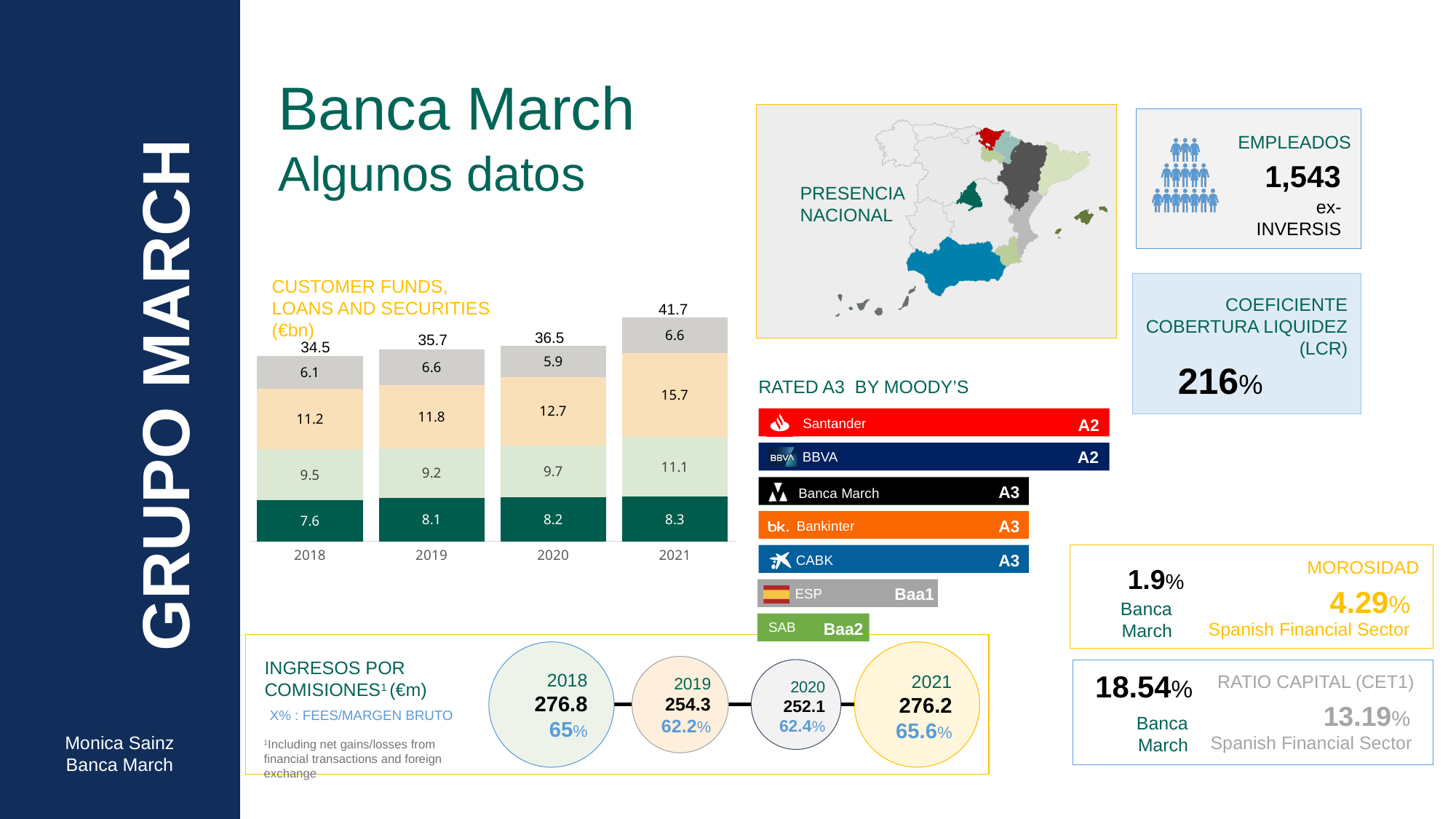
In the 'Customer funds, loans and securities (€bn)' chart, what is the value of the peach (second from top) segment for 2020? 12.7 How many years are shown on the x axis of the 'Customer funds, loans and securities (€bn)' chart? 4 What kind of chart is the 'Customer funds, loans and securities (€bn)' chart? Stacked bar chart In the 'Ingresos por comisiones (€m)' graphic, what is the value for 2019? 254.3 In the 'Customer funds, loans and securities (€bn)' chart, do the totals rise or fall from 2018 to 2021? Rise In the 'Customer funds, loans and securities (€bn)' chart, what is the value of the bottom dark green segment for 2018? 7.6 In the 'Customer funds, loans and securities (€bn)' chart, which year has the highest total? 2021 In the 'Customer funds, loans and securities (€bn)' chart, is the peach segment larger in 2021 or in 2019? 2021 In the 'Rated A3 by Moody's' chart, what rating is shown for Bankinter? A3 In the 'Customer funds, loans and securities (€bn)' chart, what is the total for 2021? 41.7 In the 'Customer funds, loans and securities (€bn)' chart, which year has the lowest total? 2018 In the 'Customer funds, loans and securities (€bn)' chart, what is the difference between the 2021 total and the 2020 total? 5.2